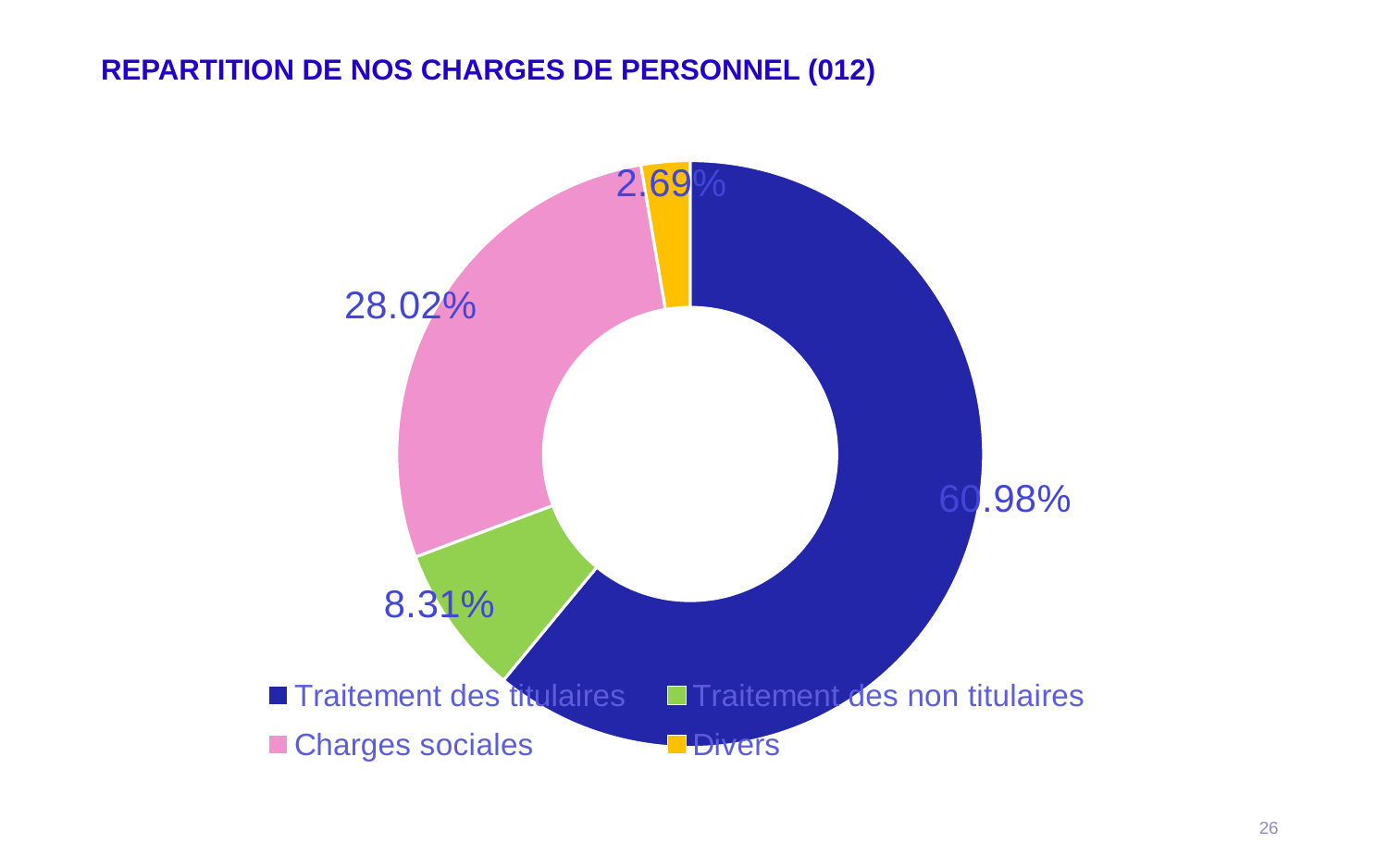
Which is larger, Charges sociales or Traitement des non titulaires? Charges sociales Which category has the largest share of personnel charges? Traitement des titulaires What kind of chart is shown on the slide? Doughnut (pie) chart What share of personnel charges is Traitement des titulaires? 60.98% What colour represents Divers in the chart? Yellow How many categories does the chart show? 4 What is the title of the chart? REPARTITION DE NOS CHARGES DE PERSONNEL (012) Which category has the smallest share of personnel charges? Divers What is the difference in percentage points between Traitement des titulaires and Charges sociales? 32.96 What share of personnel charges is Traitement des non titulaires? 8.31% What share of personnel charges is Divers? 2.69% What share of personnel charges is Charges sociales? 28.02%